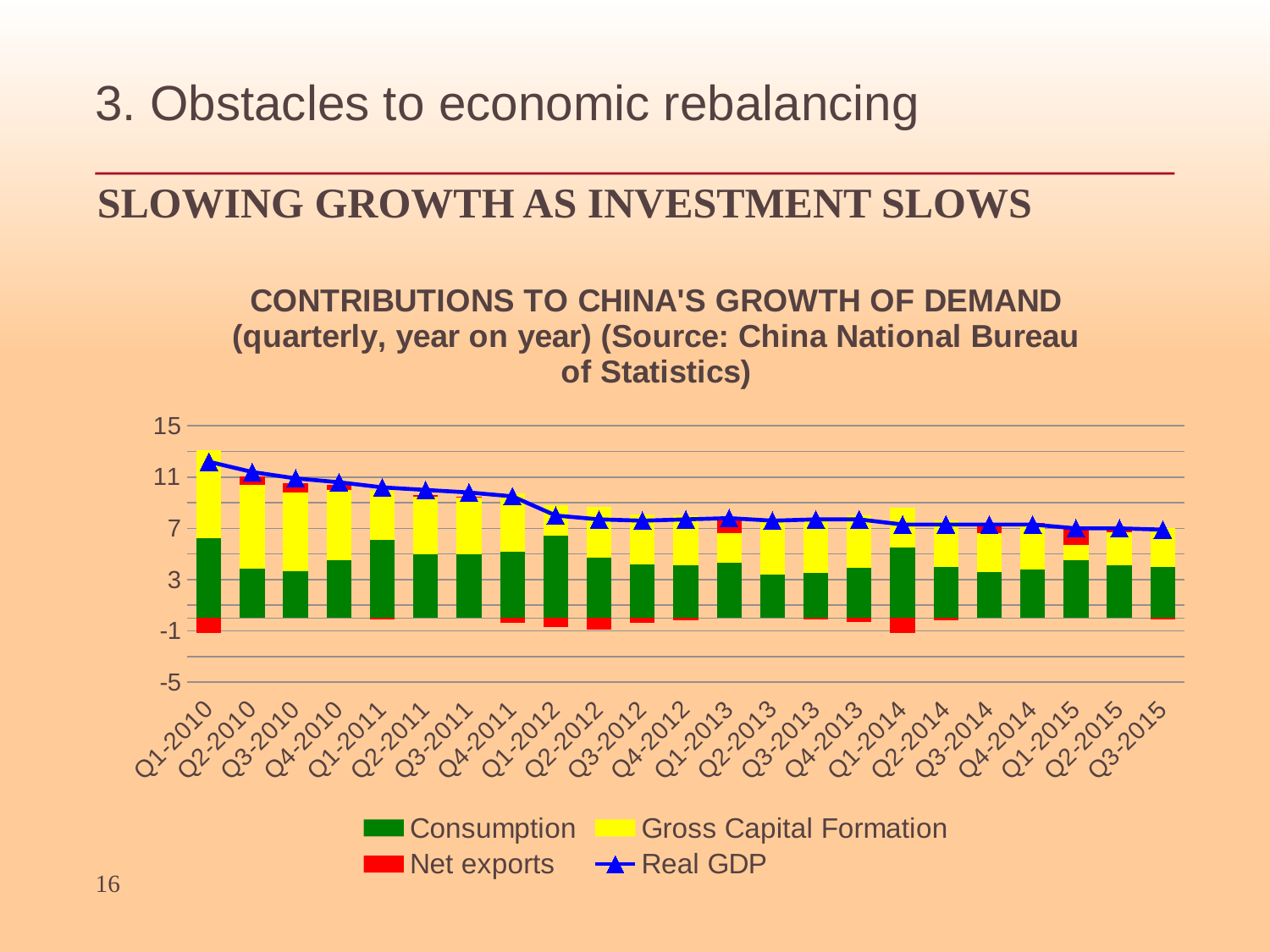
Is the Consumption contribution in Q1-2010 greater or less than 3? greater Is Real GDP in Q1-2010 greater or less than 11? greater Is Real GDP in Q1-2012 greater or less than 11? less How many quarters are shown along the x axis of the chart? 23 What colour represents Consumption in the chart? Green How many series does the chart's legend list? 4 Does the Real GDP line rise or fall from Q1-2010 to Q3-2015? Fall What kind of chart is shown on the slide? A stacked bar chart with a line overlay In which quarter is Real GDP highest? Q1-2010 Which series are listed in the chart's legend? Consumption, Gross Capital Formation, Net exports, Real GDP Which is larger, Real GDP in Q1-2010 or Real GDP in Q3-2015? Q1-2010